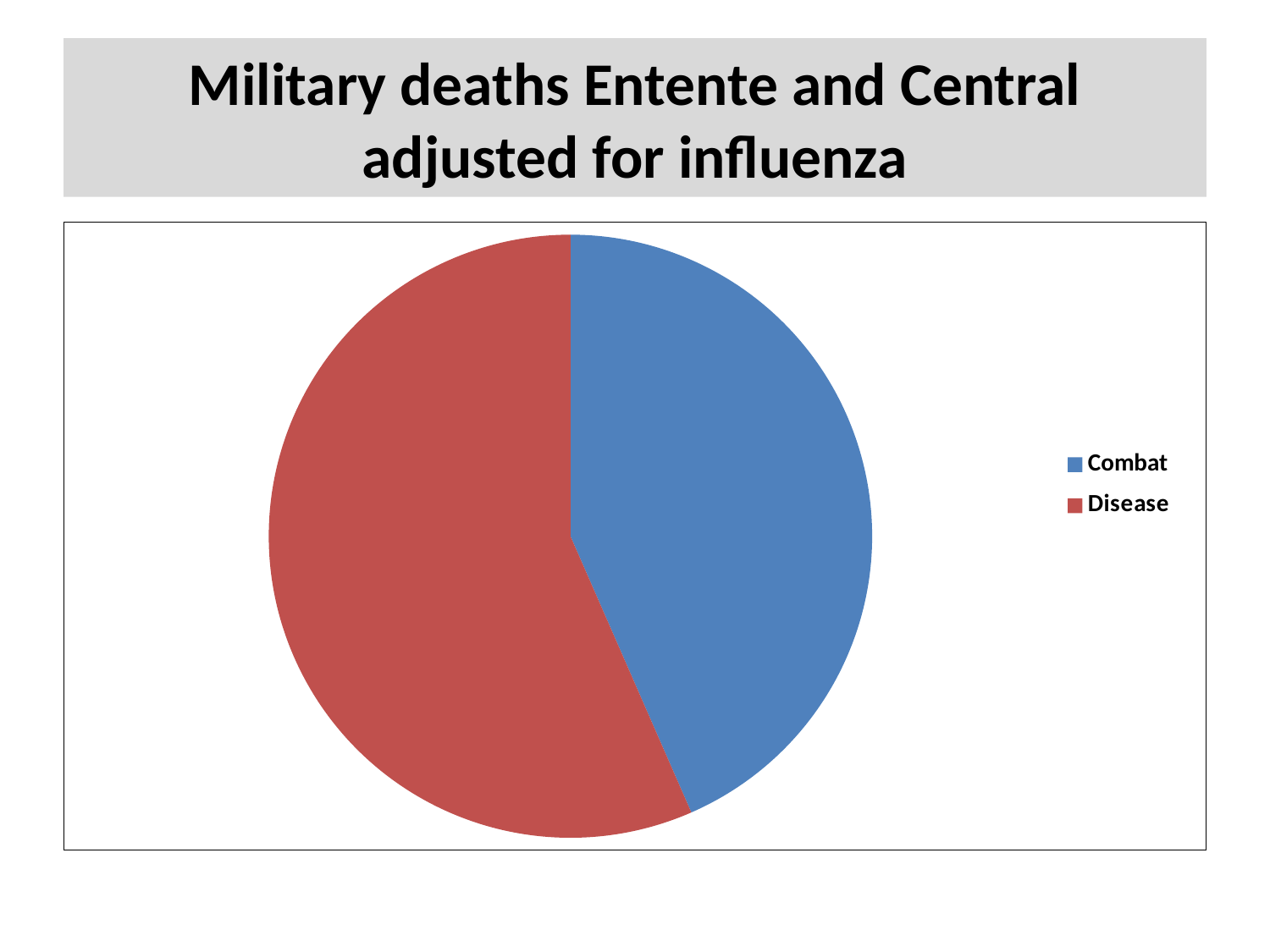
Which slice is larger, Combat or Disease? Disease How many entries does the legend list? 2 Which category has the largest slice of the pie? Disease What kind of chart is shown on the slide? Pie chart How many slices does the pie chart have? 2 What colour is the Combat slice? Blue What is the title of the chart on the slide? Military deaths Entente and Central adjusted for influenza Which category has the smallest slice of the pie? Combat Does the Disease slice take up more or less than half of the pie? More